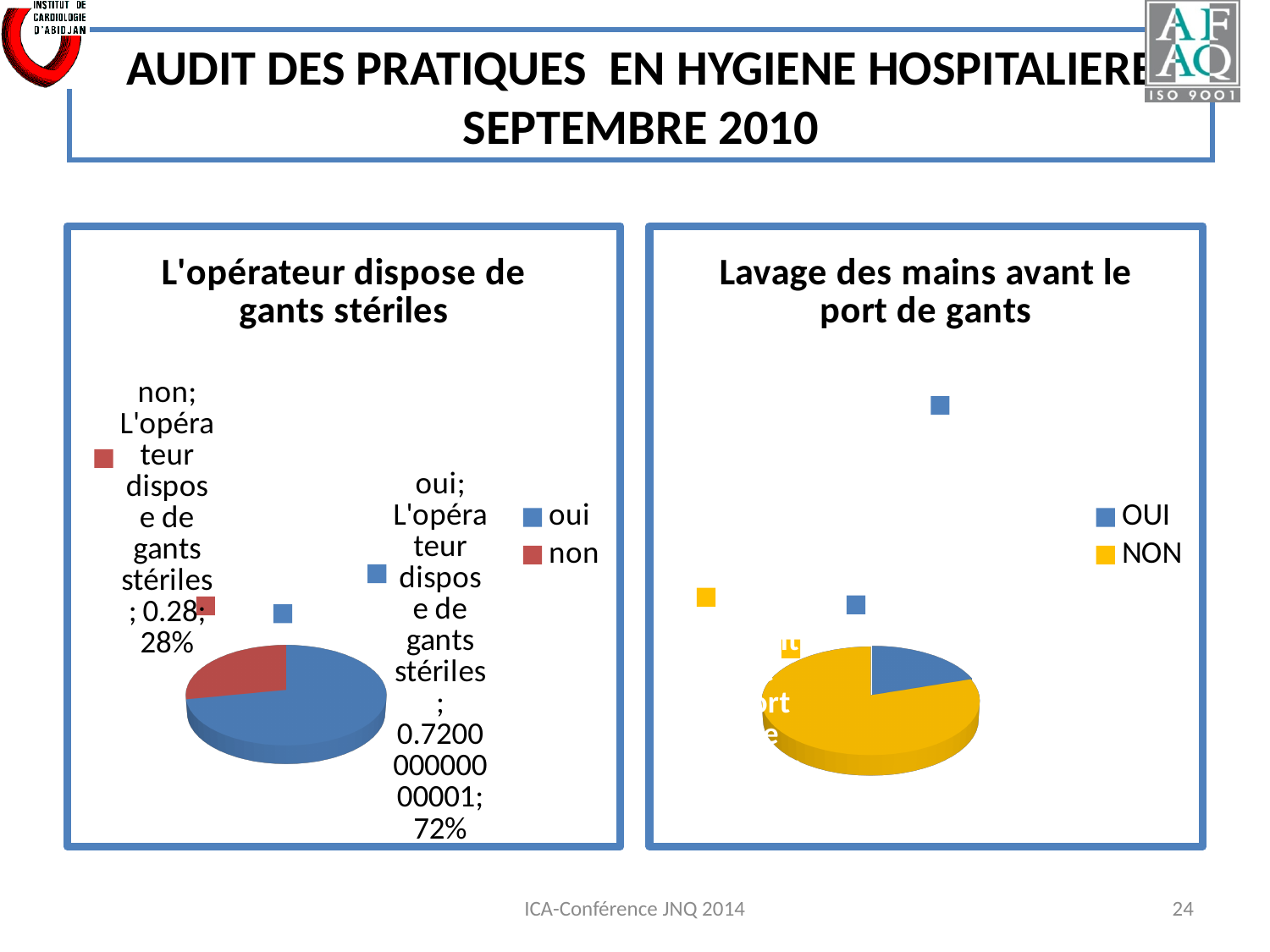
How many entries does the legend of the chart 'Lavage des mains avant le port de gants' list? 2 In the chart 'L'opérateur dispose de gants stériles', what percentage share does 'non' have? 28% In the chart 'Lavage des mains avant le port de gants', which category has the larger slice, OUI or NON? NON How many entries does the legend of the chart 'L'opérateur dispose de gants stériles' list? 2 What kind of chart is 'L'opérateur dispose de gants stériles'? pie chart In the chart 'L'opérateur dispose de gants stériles', what percentage share does 'oui' have? 72% In the chart 'L'opérateur dispose de gants stériles', what is the difference in percentage points between 'oui' and 'non'? 44 What kind of chart is 'Lavage des mains avant le port de gants'? pie chart In the chart 'L'opérateur dispose de gants stériles', which category has the largest slice? oui In the chart 'L'opérateur dispose de gants stériles', which category has the smallest slice? non In the chart 'Lavage des mains avant le port de gants', what colour is the NON slice? yellow How many pie charts are shown on the slide? 2